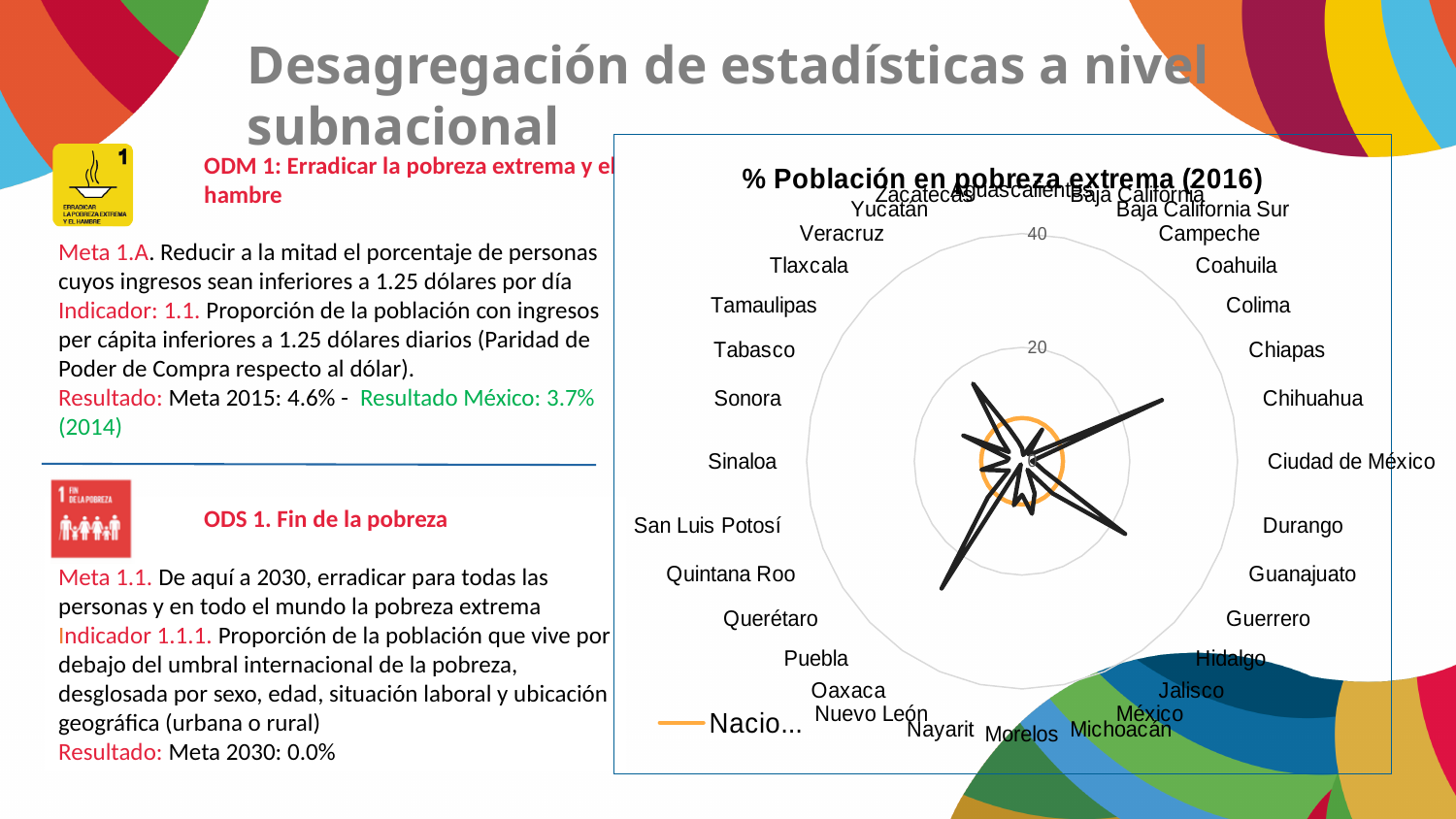
What is the highest tick value shown on the chart's axis? 40 What is the title of the chart? % Población en pobreza extrema (2016) Is the value for Nuevo León greater or less than 20? less How many states (categories) are plotted around the radar chart? 32 Is the value for Chiapas greater or less than 20? greater Is the value for Chiapas greater or less than 40? less What kind of chart is shown on the slide? Radar chart Which state has the highest value in the chart? Chiapas Which is larger, the value for Chiapas or the value for Nuevo León? Chiapas